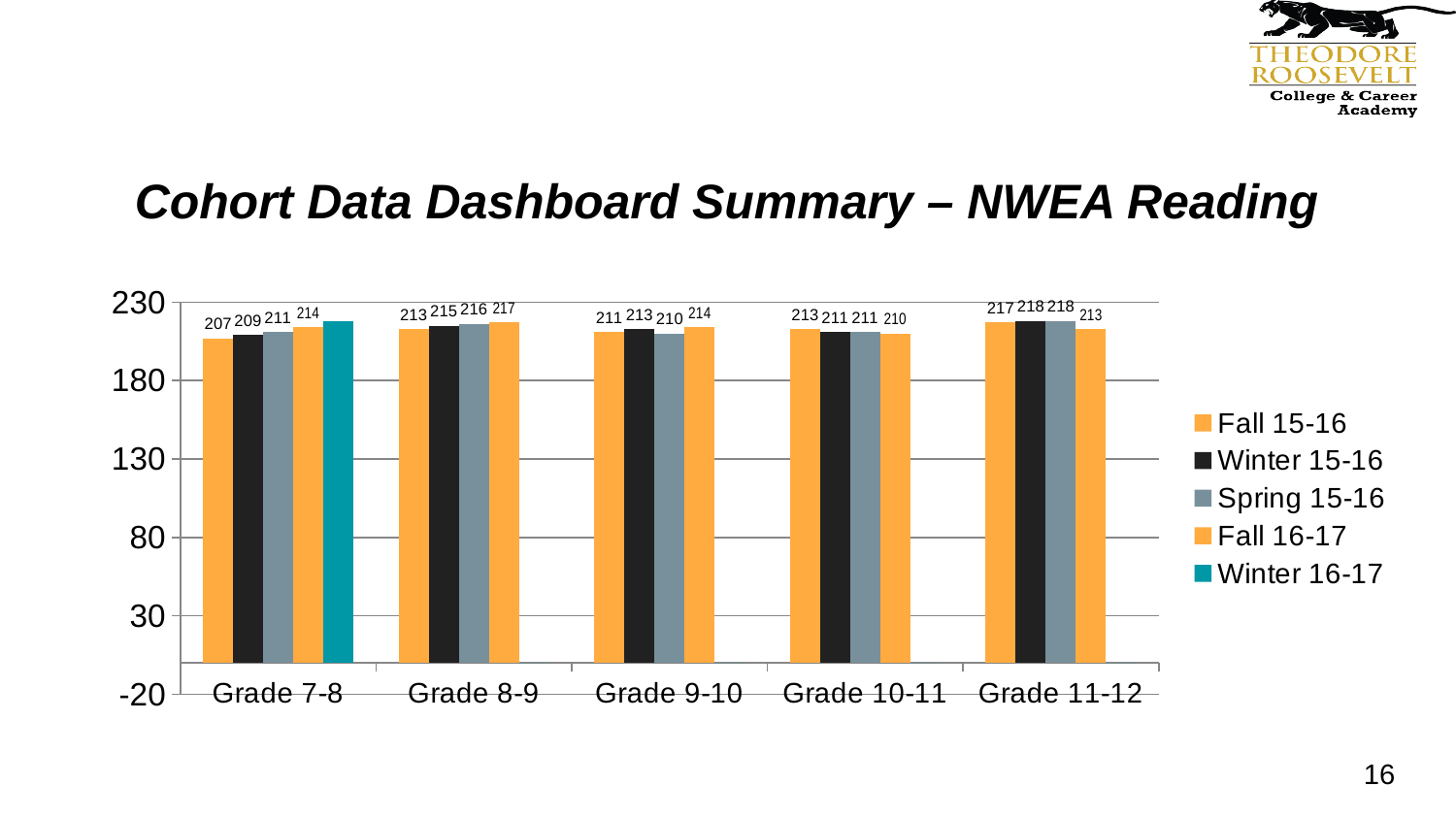
For Grade 7-8, how much higher is the Fall 16-17 value than the Fall 15-16 value? 7 How many series does the legend list? 5 What is the Spring 15-16 value for Grade 9-10? 210 Is the Winter 16-17 value for Grade 7-8 greater or less than 180? greater What is the Fall 16-17 value for Grade 8-9? 217 For Grade 10-11, which is larger: the Fall 15-16 value or the Fall 16-17 value? Fall 15-16 Which grade cohort has the lowest Fall 15-16 value? Grade 7-8 How many grade cohorts are shown on the x axis? 5 What is the Winter 15-16 value for Grade 11-12? 218 Which grade cohort has the highest Fall 15-16 value? Grade 11-12 What is the Fall 15-16 value for Grade 7-8? 207 What kind of chart is shown on the slide? bar chart